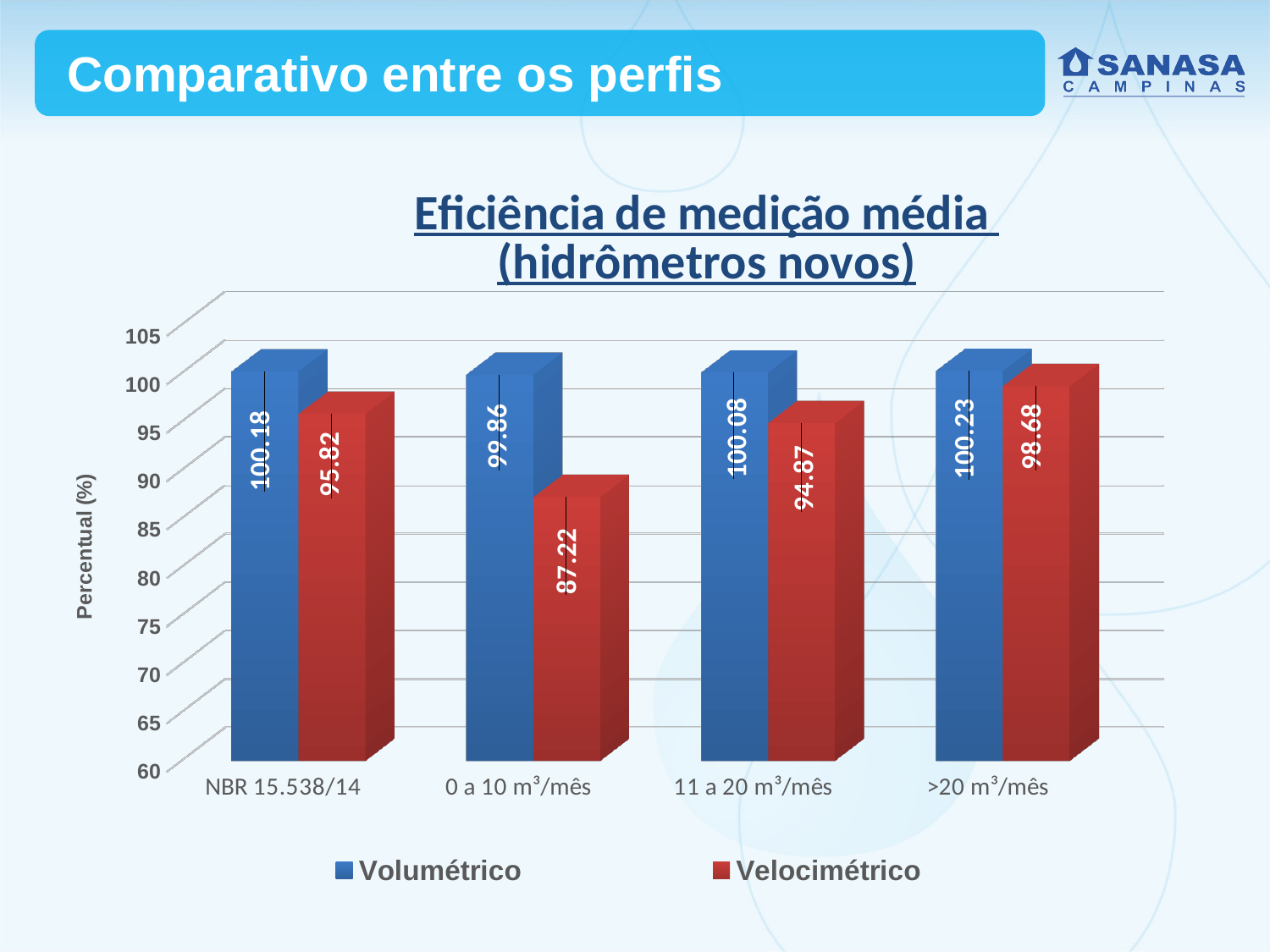
What is the Velocimétrico value for >20 m³/mês? 98.68 What is the Volumétrico value for NBR 15.538/14? 100.18 Which category has the highest Velocimétrico value? >20 m³/mês What is the Velocimétrico value for 0 a 10 m³/mês? 87.22 What kind of chart is shown on the slide? bar chart What is the Volumétrico value for 11 a 20 m³/mês? 100.08 What is the difference between the Volumétrico and Velocimétrico values for 0 a 10 m³/mês? 12.64 Which is larger for 11 a 20 m³/mês, Volumétrico or Velocimétrico? Volumétrico How many series does the legend list? 2 How many categories are shown on the x axis? 4 Is the Velocimétrico value for 11 a 20 m³/mês greater or less than 90? greater Which category has the lowest Velocimétrico value? 0 a 10 m³/mês